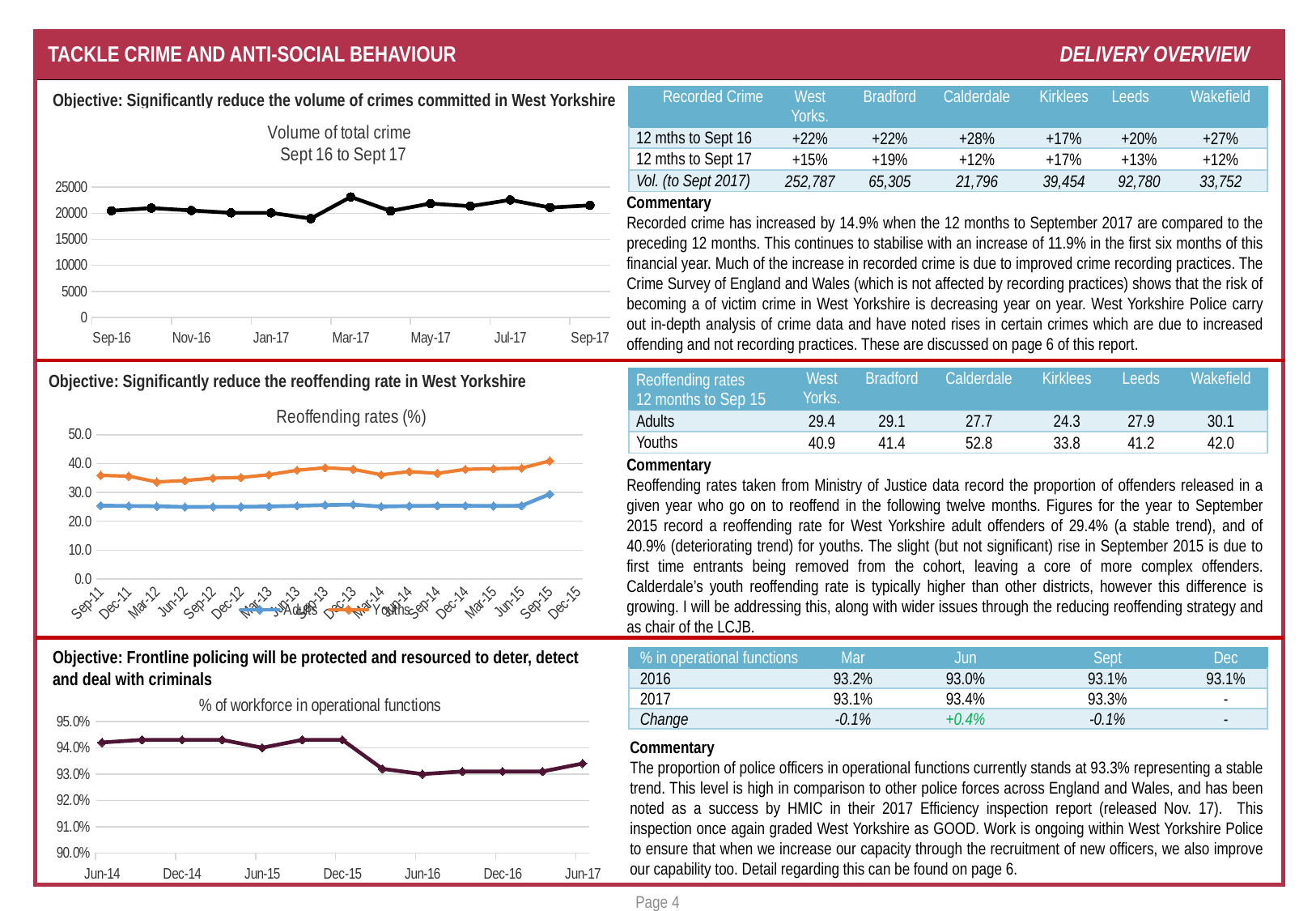
How many data points are plotted in the 'Volume of total crime Sept 16 to Sept 17' chart? 13 In the 'Reoffending rates (%)' chart, is the Youths value for Mar-12 greater or less than 40.0? less In the 'Volume of total crime Sept 16 to Sept 17' chart, which is larger, the value for Mar-17 or the value for Sep-16? Mar-17 How many series does the legend of the 'Reoffending rates (%)' chart list? 2 In the 'Reoffending rates (%)' chart, is the Adults value for Sep-11 greater or less than 30.0? less In the 'Volume of total crime Sept 16 to Sept 17' chart, is the value for Mar-17 greater or less than 20000? greater In the '% of workforce in operational functions' chart, which is larger, the value for Jun-14 or the value for Jun-16? Jun-14 What kind of chart is the '% of workforce in operational functions' chart? line chart What kind of chart is the 'Volume of total crime Sept 16 to Sept 17' chart? line chart